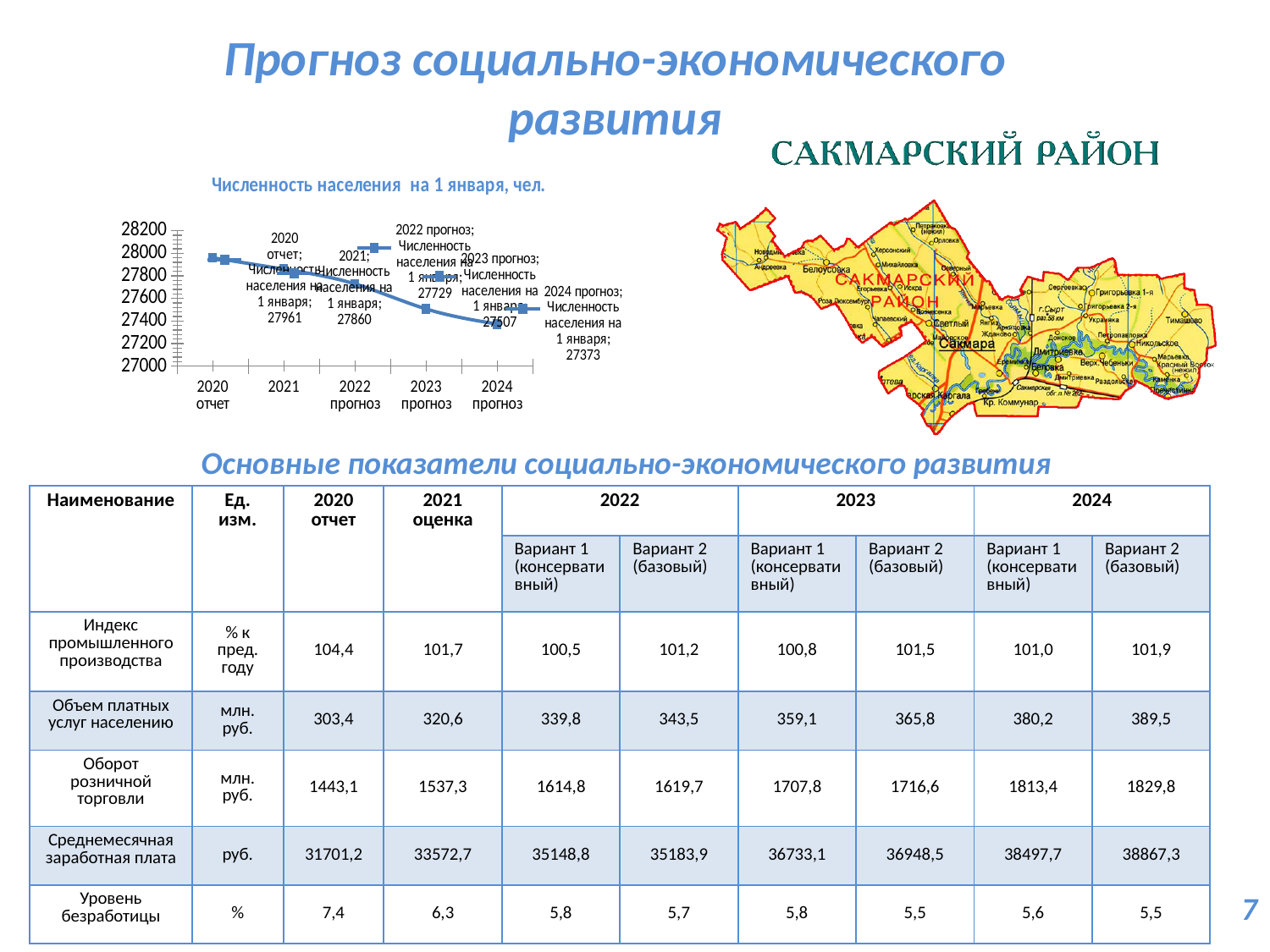
What is the population value shown for 2021 in the population chart? 27860 What is the population value shown for 2020 отчет in the population chart? 27961 Which year has the lowest population value in the population chart? 2024 прогноз How many years (data points) are plotted in the population chart? 5 Does the population in the chart rise or fall from 2020 to 2024? fall Which year has the highest population value in the population chart? 2020 отчет What type of chart is used to show the population (Численность населения на 1 января, чел.)? line chart What is the population value shown for 2022 прогноз in the population chart? 27729 What is the population value shown for 2024 прогноз in the population chart? 27373 In the population chart, what is the difference between the 2020 отчет value and the 2024 прогноз value? 588 What is the population value shown for 2023 прогноз in the population chart? 27507 In the population chart, which is larger: the value for 2021 or the value for 2023 прогноз? 2021